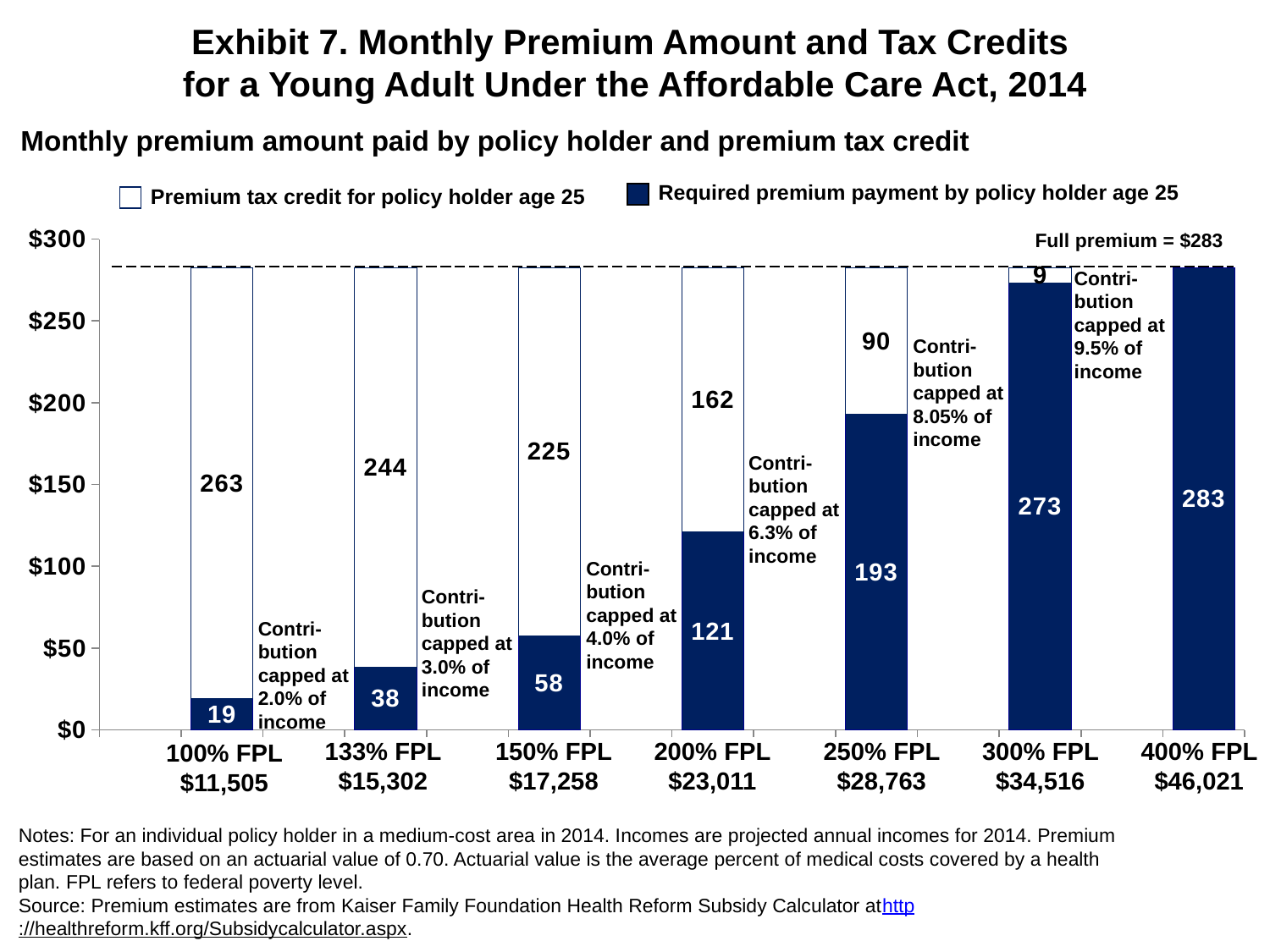
Which is larger at 200% FPL: the premium tax credit or the required premium payment? Premium tax credit What is the premium tax credit for the policy holder age 25 at 200% FPL? 162 What is the required premium payment by the policy holder age 25 at 250% FPL? 193 What is the required premium payment by the policy holder age 25 at 100% FPL? 19 What is the total of the stacked bar at 250% FPL (tax credit plus required premium payment)? 283 How many series does the legend list? 2 What kind of chart is shown on the slide? Stacked bar chart At which FPL level is the required premium payment the lowest? 100% FPL What is the difference between the premium tax credit at 133% FPL and at 150% FPL? 19 Does the required premium payment rise or fall as the FPL level increases along the x axis? Rise At which FPL level is the premium tax credit the highest? 100% FPL How many FPL categories are shown on the x axis? 7